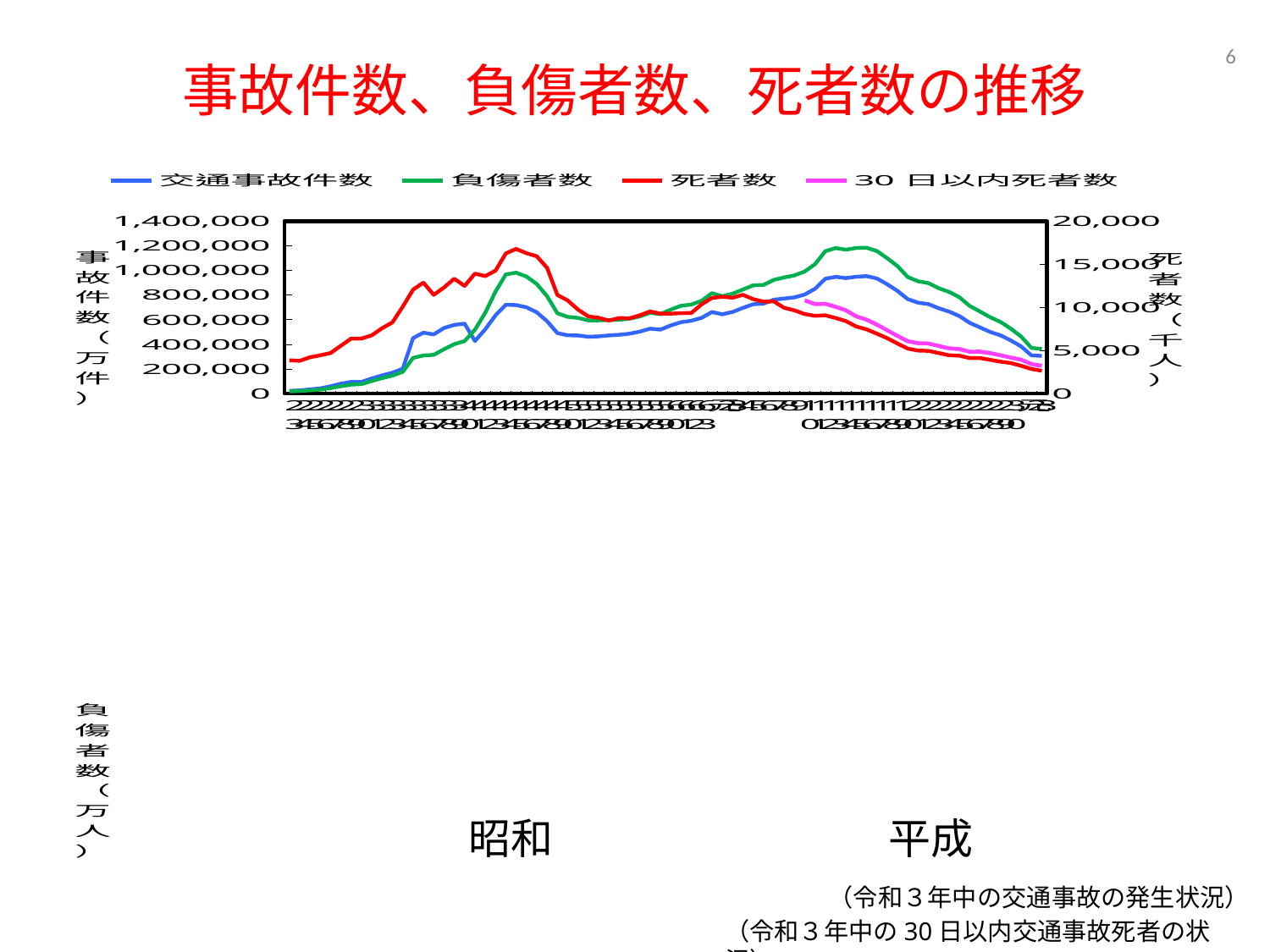
Over the rightmost part of the chart (the later 平成 years), do the lines rise or fall? fall At the right end of the chart, which line is higher, 負傷者数 or 交通事故件数? 負傷者数 Which colour is used for the 死者数 series? red Is the peak value of the 交通事故件数 line greater or less than 1,000,000 on the left axis? less What kind of chart is shown on the slide? line chart Is the peak value of the 負傷者数 line greater or less than 1,000,000 on the left axis? greater At the right end of the chart, is the 死者数 value greater or less than 5,000 on the right axis? less What is the title of the chart? 事故件数、負傷者数、死者数の推移 How many series does the legend list? 4 Which of the series plotted on the left axis, 交通事故件数 or 負傷者数, reaches the higher peak? 負傷者数